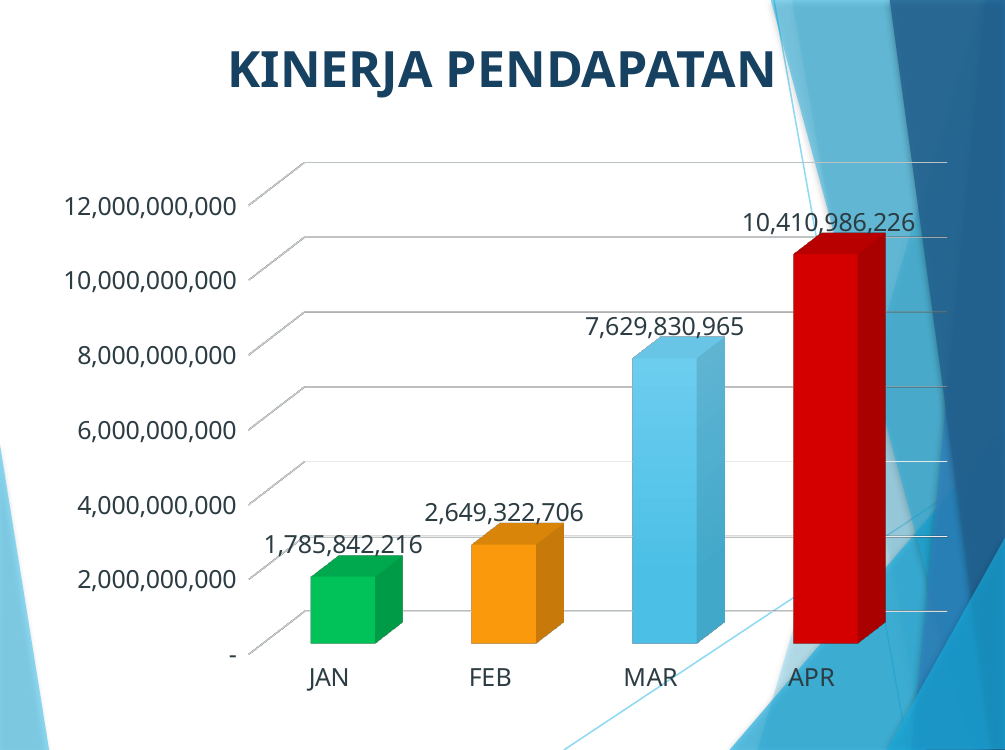
Which month has the highest value? APR Which is larger, the value for FEB or the value for MAR? MAR What kind of chart is shown on the slide? bar chart Is the value for MAR greater or less than 8,000,000,000? less Which month has the lowest value? JAN Do the values rise or fall from JAN to APR? rise What is the value for JAN? 1,785,842,216 What is the difference between the values for FEB and JAN? 863,480,490 What is the value for MAR? 7,629,830,965 How many months are shown on the chart? 4 What is the difference between the values for APR and MAR? 2,781,155,261 What is the value for APR? 10,410,986,226